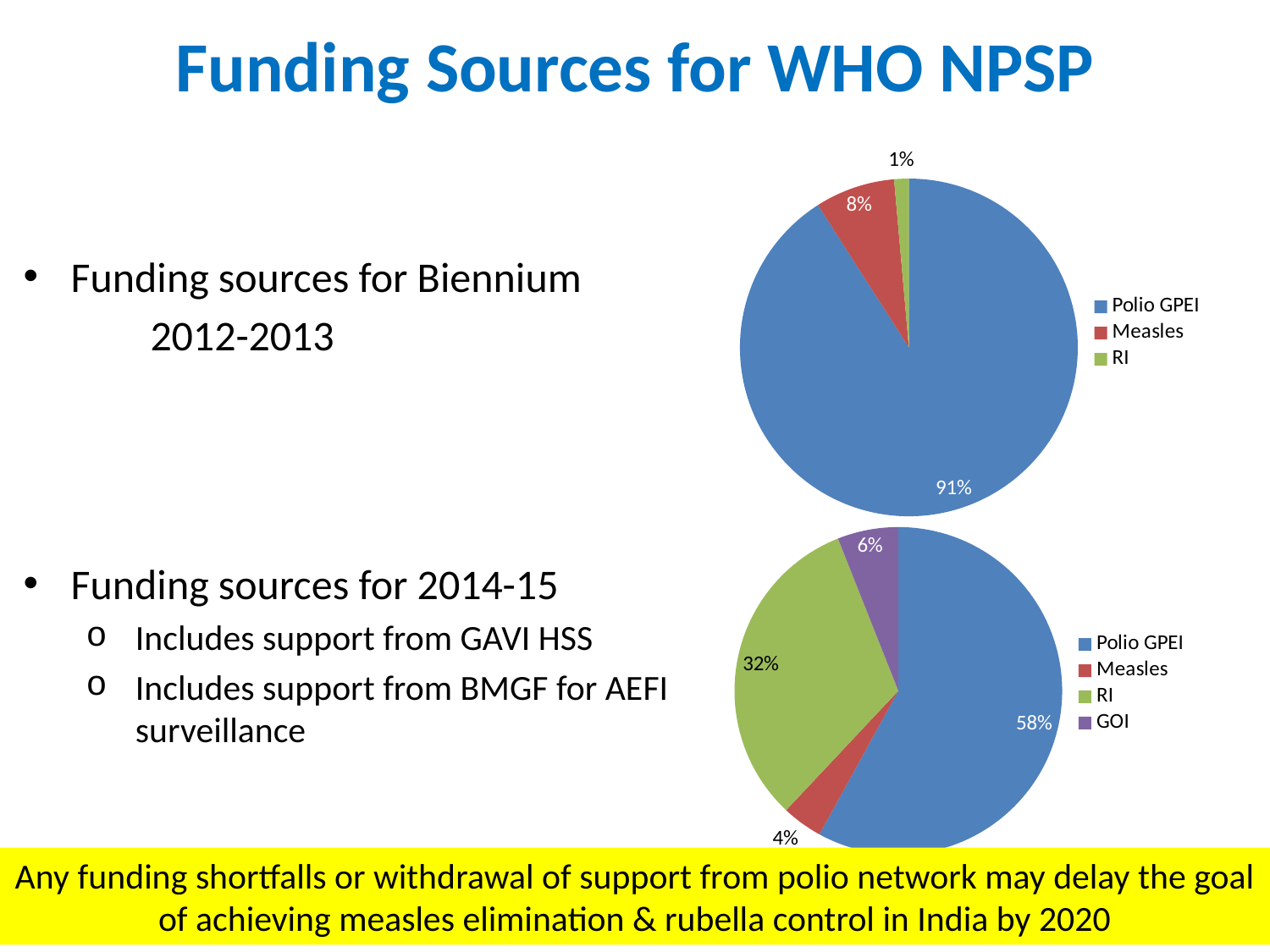
In the bottom pie chart, what share does RI have? 32% In the top pie chart, what share does RI have? 1% How many categories does the legend of the bottom pie chart list? 4 In the bottom pie chart, which is larger, the RI slice or the GOI slice? RI In the top pie chart, what share does Polio GPEI have? 91% In the top pie chart, what share does Measles have? 8% In the bottom pie chart, which category has the largest slice? Polio GPEI In the top pie chart, which category has the smallest slice? RI What type of chart is the top chart on the slide? Pie chart In the bottom pie chart, which category has the smallest slice? Measles In the bottom pie chart, what is the difference between the Polio GPEI share and the RI share? 26% In the bottom pie chart, what share does GOI have? 6%